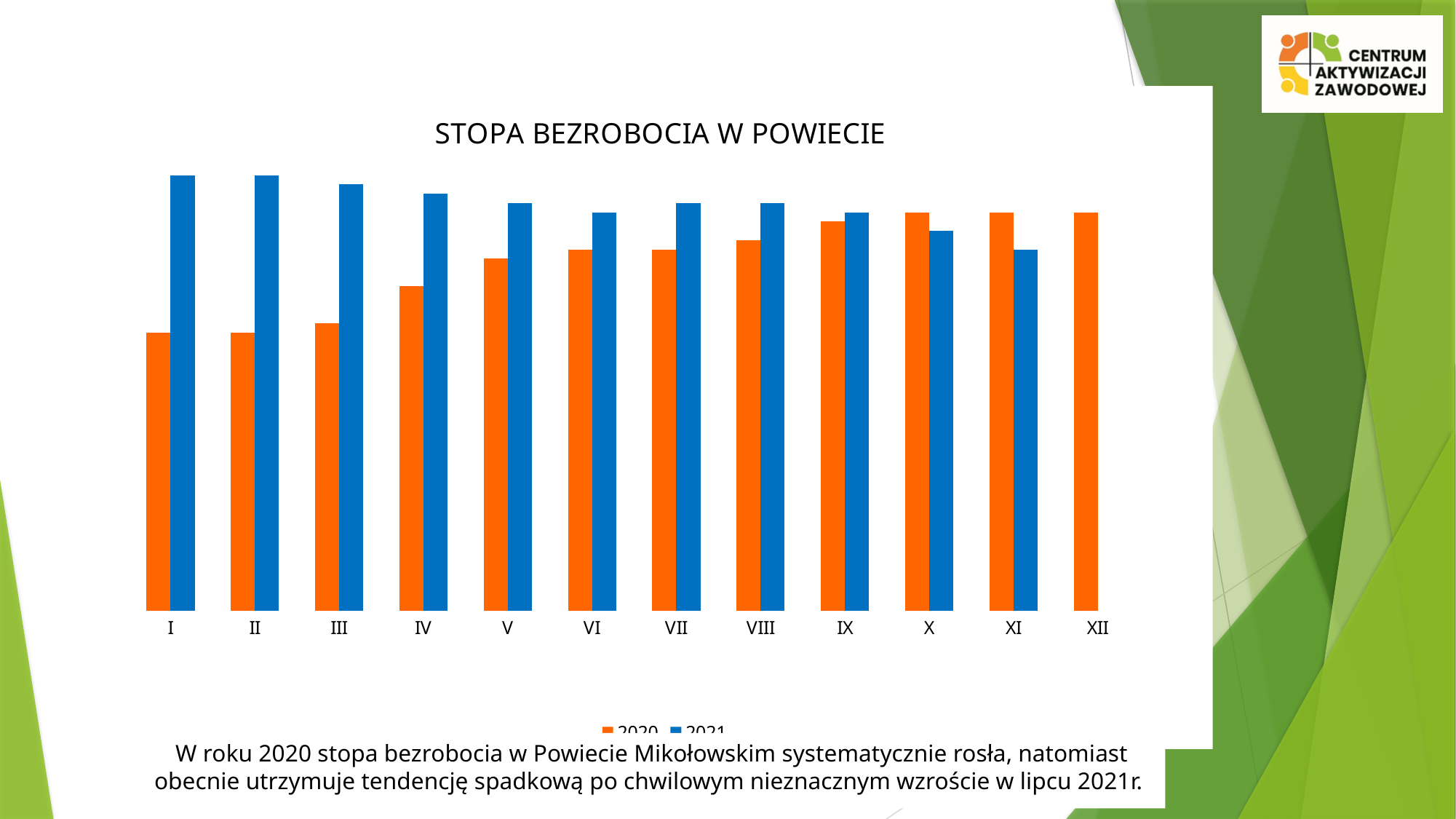
Do the 2021 values generally rise or fall from month I to month XI? fall Do the 2020 values rise or fall from month I to month XII? rise Which month has the lowest value for the 2021 series? XI How many series does the legend list? 2 Which colour represents the 2020 series? orange In month IV, which series has the larger value, 2020 or 2021? 2021 What kind of chart is shown on the slide? bar chart What is the title of the chart? STOPA BEZROBOCIA W POWIECIE How many categories (months) are shown on the x axis? 12 In month I, which series has the larger value, 2020 or 2021? 2021 Which month has no bar for the 2021 series? XII In month XI, which series has the larger value, 2020 or 2021? 2020